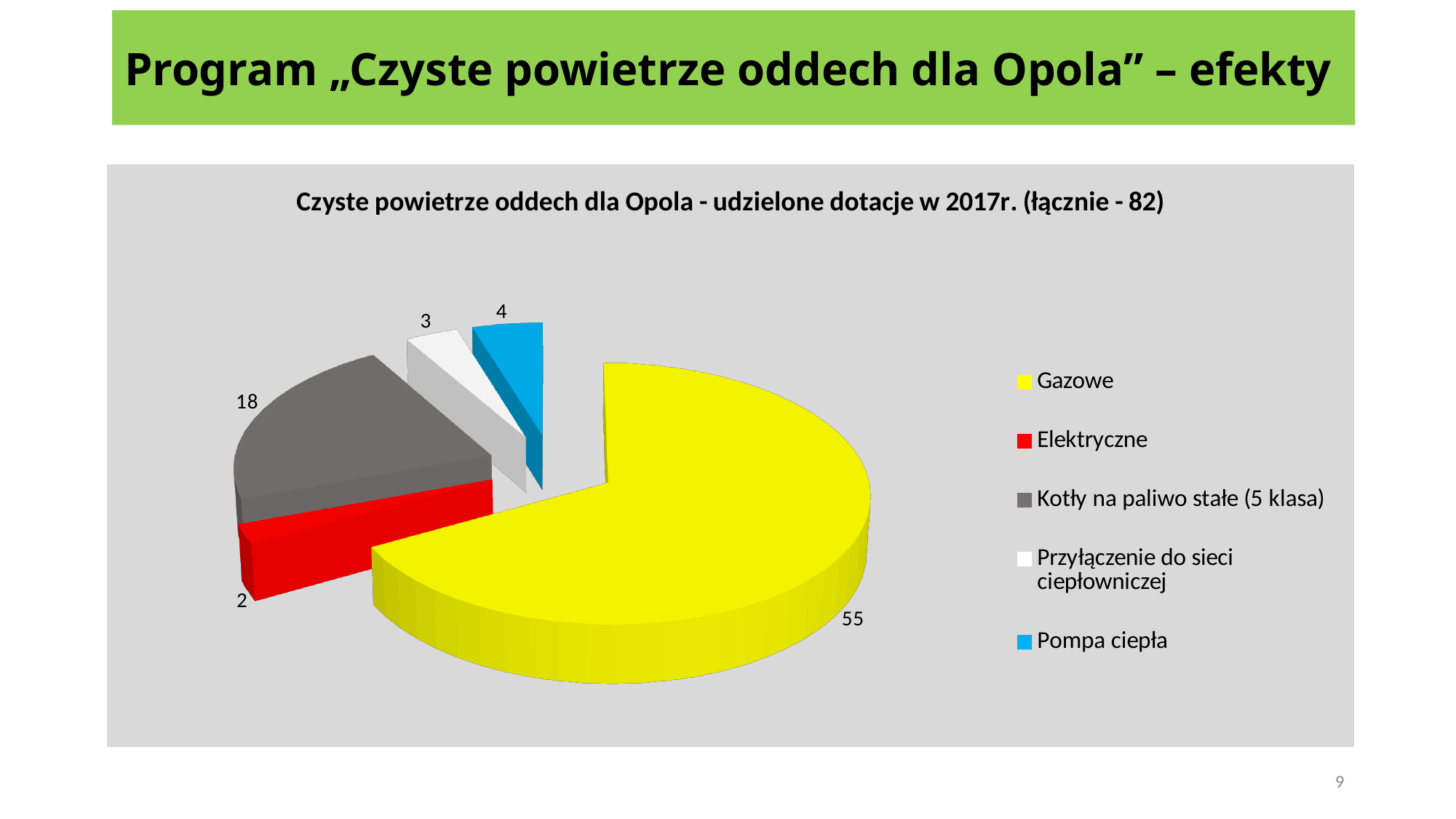
What is the value for Elektryczne? 2 What is the value for Pompa ciepła? 4 What is the value for Kotły na paliwo stałe (5 klasa)? 18 How many categories does the pie chart have? 5 What is the value for Przyłączenie do sieci ciepłowniczej? 3 Which category has the smallest slice of the pie? Elektryczne Which is larger, the value for Pompa ciepła or the value for Przyłączenie do sieci ciepłowniczej? Pompa ciepła What total number of grants is stated in the chart title? 82 Which category has the largest slice of the pie? Gazowe How many grants (dotacje) were given for Gazowe? 55 What is the difference between the values for Gazowe and Kotły na paliwo stałe (5 klasa)? 37 What type of chart is shown on the slide? pie chart